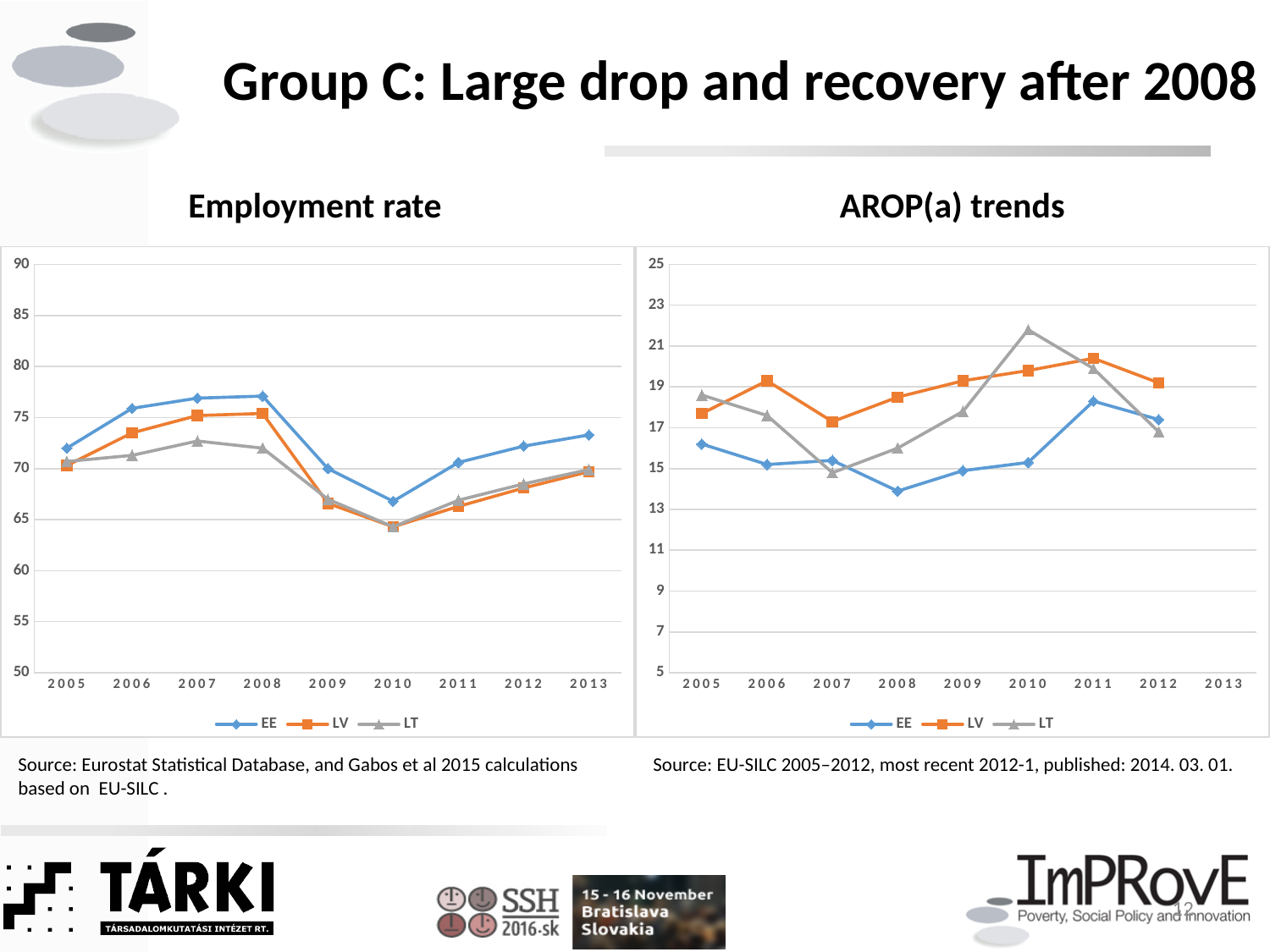
On the Employment rate chart, does the EE line rise or fall from 2008 to 2010? fall On the AROP(a) trends chart, which is larger in 2006, LV or EE? LV On the AROP(a) trends chart, which series is highest in 2010? LT On the AROP(a) trends chart, is the value for EE in 2008 greater or less than 15? less On the Employment rate chart, which series is highest in 2007? EE On the AROP(a) trends chart, how many series does the legend list? 3 On the Employment rate chart, is the value for LV in 2010 greater or less than 65? less On the Employment rate chart, is the value for EE in 2008 greater or less than 75? greater On the Employment rate chart, how many series does the legend list? 3 On the Employment rate chart, how many years are shown on the x axis? 9 On the Employment rate chart, which series is highest in 2010? EE On the Employment rate chart, what kind of chart is it? line chart